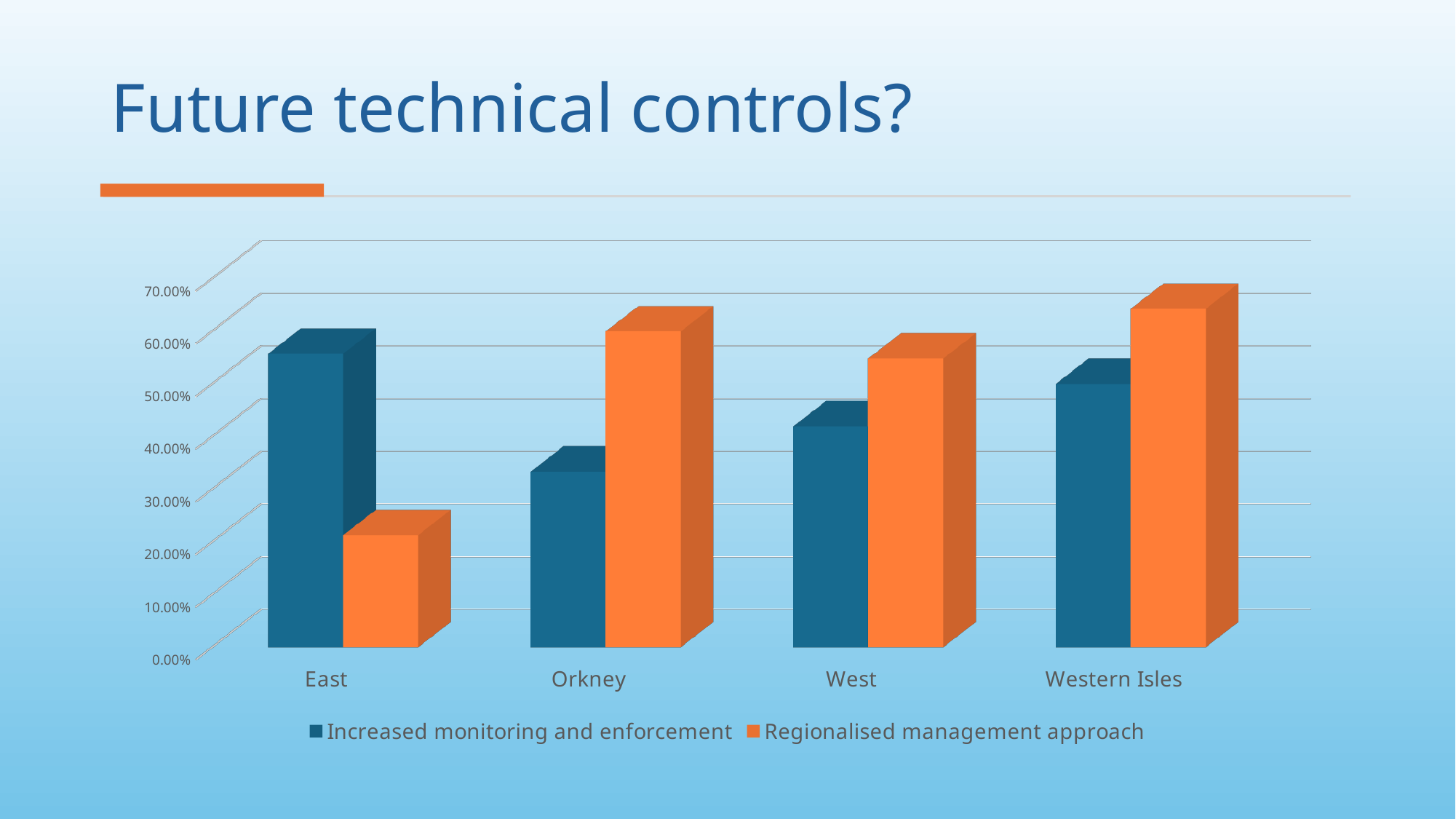
How many categories are shown on the x axis of the chart? 4 How many series does the chart's legend list? 2 Is the value for Increased monitoring and enforcement in East greater or less than 50.00%? greater Which category has the highest value for Increased monitoring and enforcement? East Is the value for Regionalised management approach in East greater or less than 30.00%? less What kind of chart is shown on the slide? bar chart Which category has the lowest value for Increased monitoring and enforcement? Orkney For East, which series has the larger value: Increased monitoring and enforcement or Regionalised management approach? Increased monitoring and enforcement Which category has the highest value for Regionalised management approach? Western Isles Which series is shown in orange in the chart's legend? Regionalised management approach Which category has the lowest value for Regionalised management approach? East For Orkney, which series has the larger value: Increased monitoring and enforcement or Regionalised management approach? Regionalised management approach